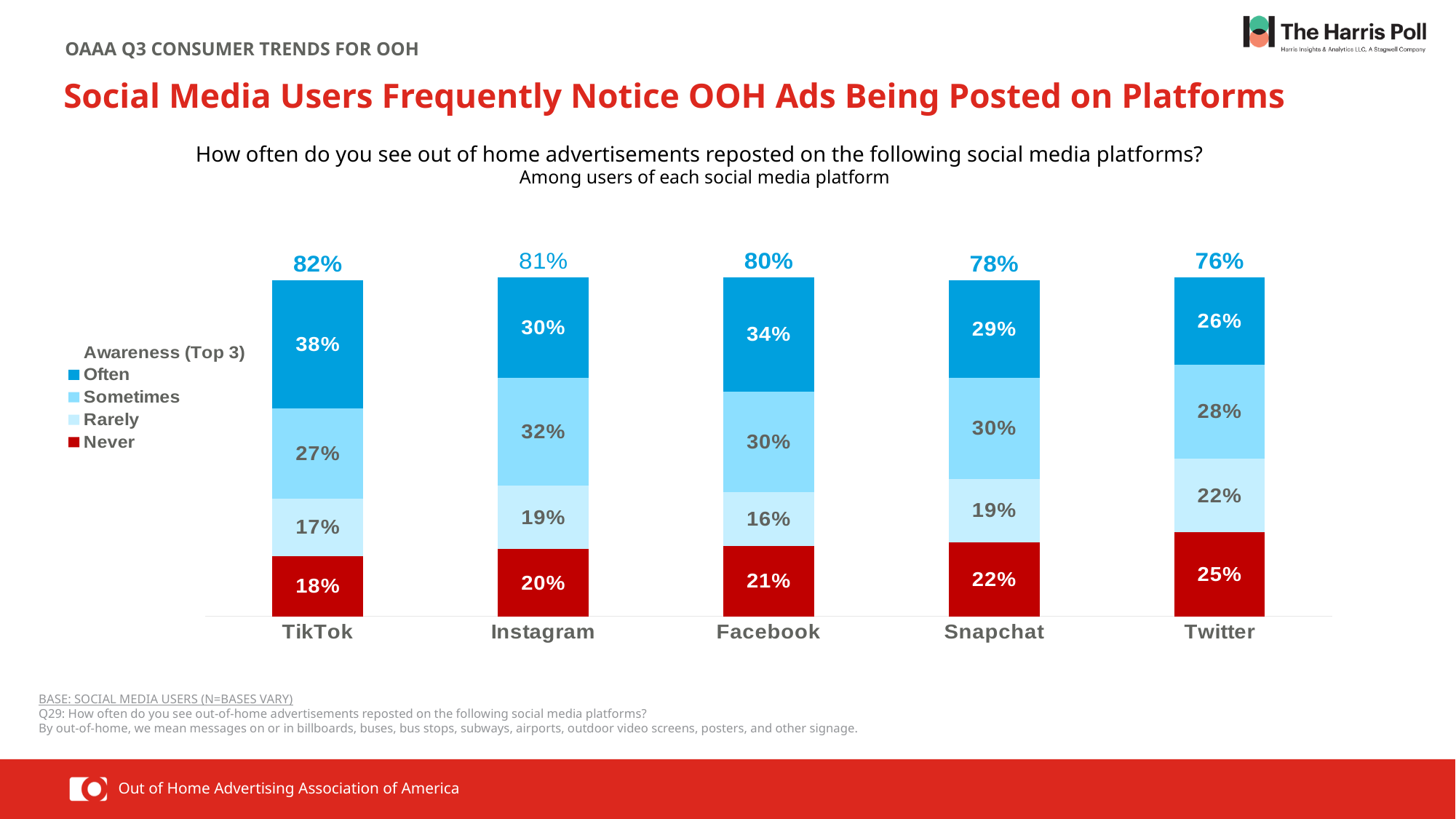
What percentage of TikTok users say they 'Often' see out of home advertisements reposted on the platform? 38% Which platform has the highest 'Often' value? TikTok What is the Awareness (Top 3) figure shown above the Snapchat bar? 78% What kind of chart is shown on the slide? Stacked bar chart What is the difference between the 'Never' values for Twitter and TikTok? 7% What is the 'Sometimes' value for Instagram? 32% How many social media platforms are shown on the x axis? 5 Which platform has the lowest Awareness (Top 3) figure? Twitter Do the Awareness (Top 3) figures rise or fall from TikTok to Twitter along the x axis? Fall What is the 'Never' value for Twitter? 25% Which is larger, the 'Rarely' value for Facebook or the 'Rarely' value for Twitter? Twitter How many series does the legend list? 4